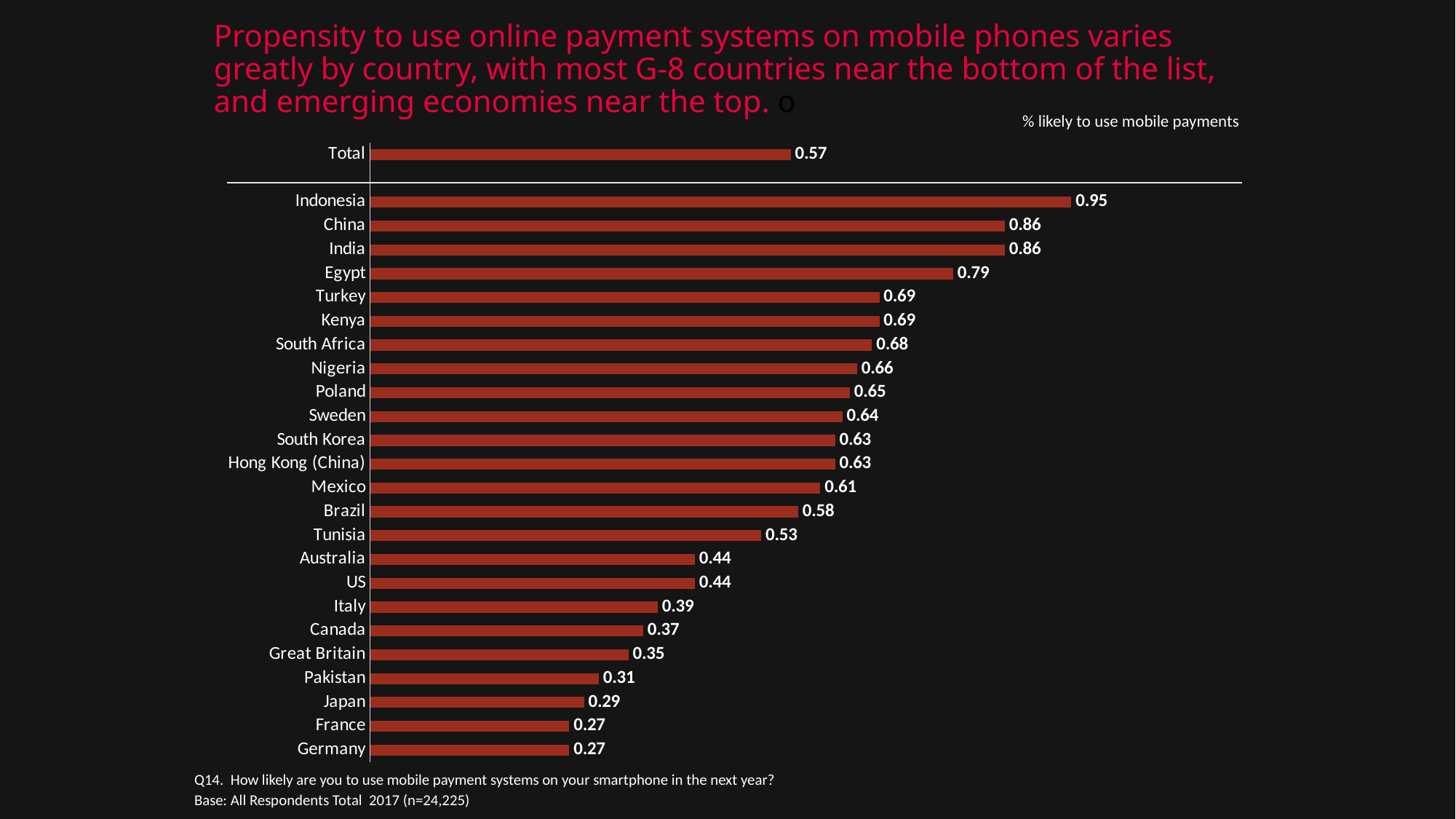
What is the value for Total? 0.57 Which country has the highest value? Indonesia What is the difference between the values for Indonesia and Germany? 0.68 What kind of chart is shown on the slide? Bar chart Do the country values rise or fall going down the chart from Indonesia to Germany? Fall What is the value for Japan? 0.29 Which is larger, the value for Canada or the value for Italy? Italy What is the value for Great Britain? 0.35 How many countries are listed below the Total bar? 24 What is the value for Indonesia? 0.95 What is the difference between the values for Egypt and Brazil? 0.21 Which is larger, the value for Mexico or the value for Tunisia? Mexico